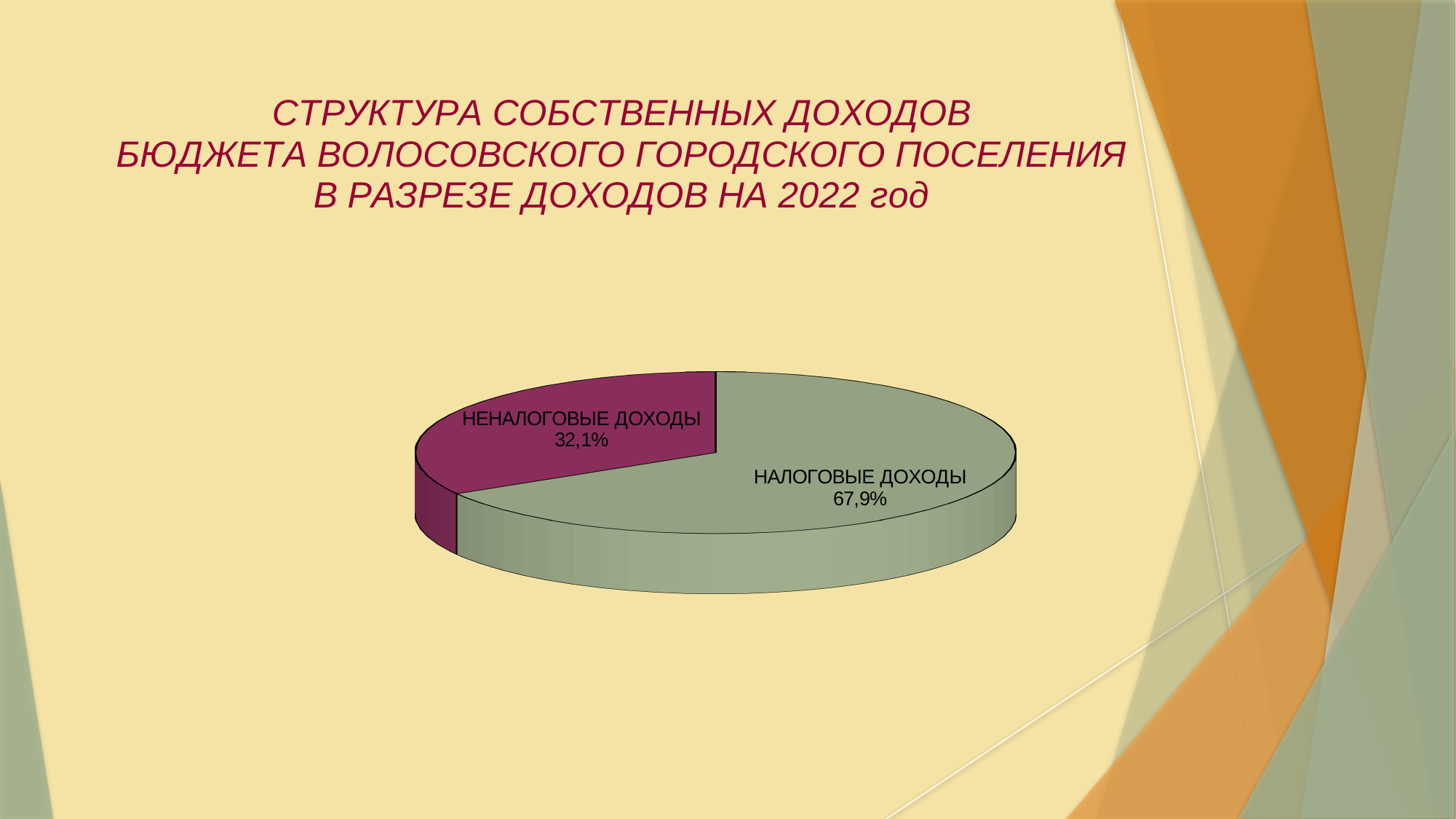
Which is larger, НАЛОГОВЫЕ ДОХОДЫ or НЕНАЛОГОВЫЕ ДОХОДЫ? НАЛОГОВЫЕ ДОХОДЫ What kind of chart is shown on the slide? Pie chart What is the difference in percentage points between НАЛОГОВЫЕ ДОХОДЫ and НЕНАЛОГОВЫЕ ДОХОДЫ? 35,8 Which slice of the pie is the smallest? НЕНАЛОГОВЫЕ ДОХОДЫ What year does the slide title say the income structure refers to? 2022 Which slice of the pie is the largest? НАЛОГОВЫЕ ДОХОДЫ What share of the pie does НАЛОГОВЫЕ ДОХОДЫ represent? 67,9% What colour is the НЕНАЛОГОВЫЕ ДОХОДЫ slice? Purple How many slices does the pie chart have? 2 What share of the pie does НЕНАЛОГОВЫЕ ДОХОДЫ represent? 32,1%